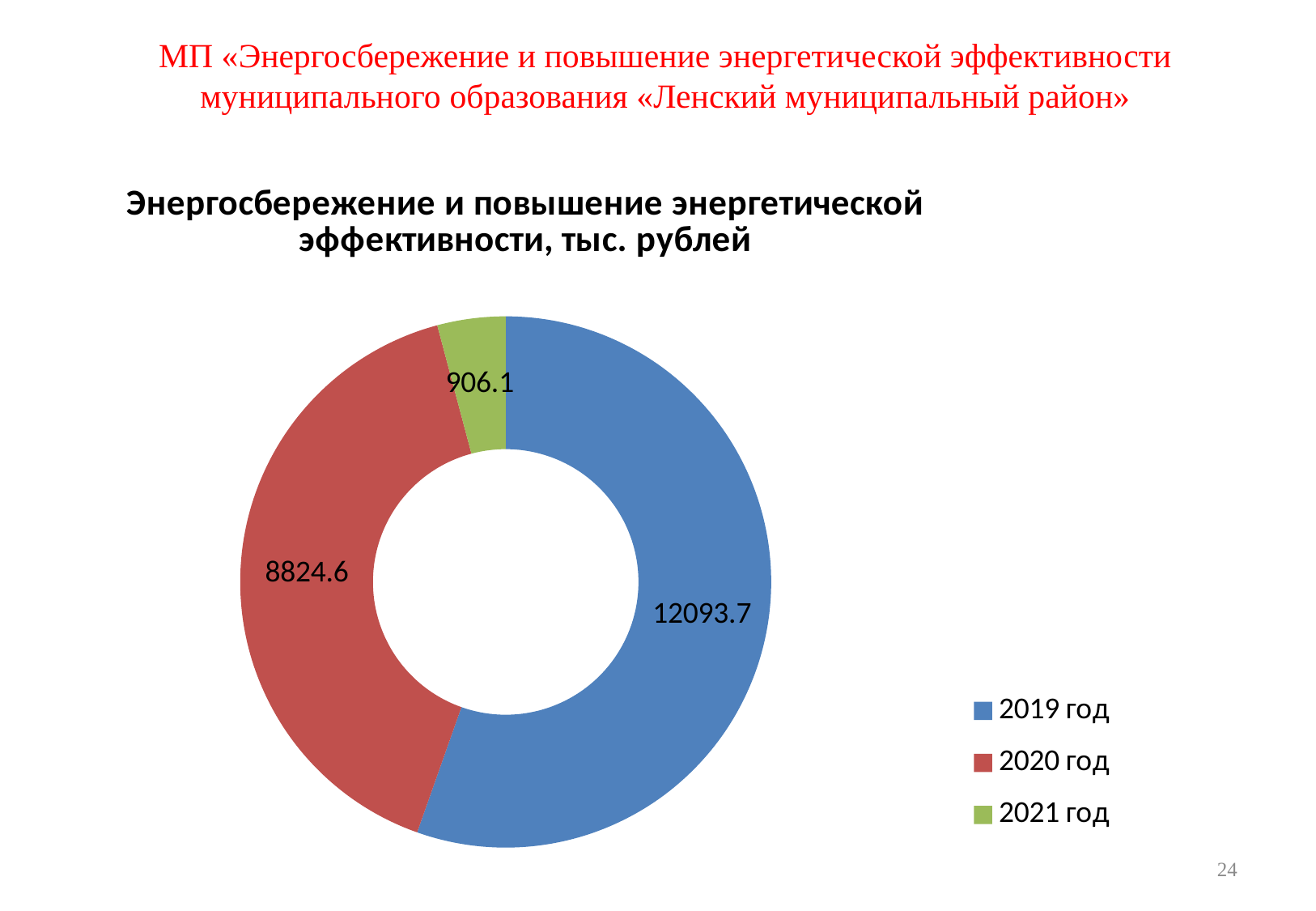
What is the value for 2020 год? 8824.6 What is the total of all three slices? 21824.4 Which year has the smallest slice? 2021 год Which year has the largest slice? 2019 год What is the difference between the values for 2019 год and 2020 год? 3269.1 What unit is given in the chart title? тыс. рублей What is the value for 2021 год? 906.1 Which is larger, the value for 2020 год or the value for 2021 год? 2020 год How many slices does the chart have? 3 What is the difference between the values for 2020 год and 2021 год? 7918.5 What kind of chart is shown on the slide? Doughnut (pie) chart What is the value for 2019 год? 12093.7